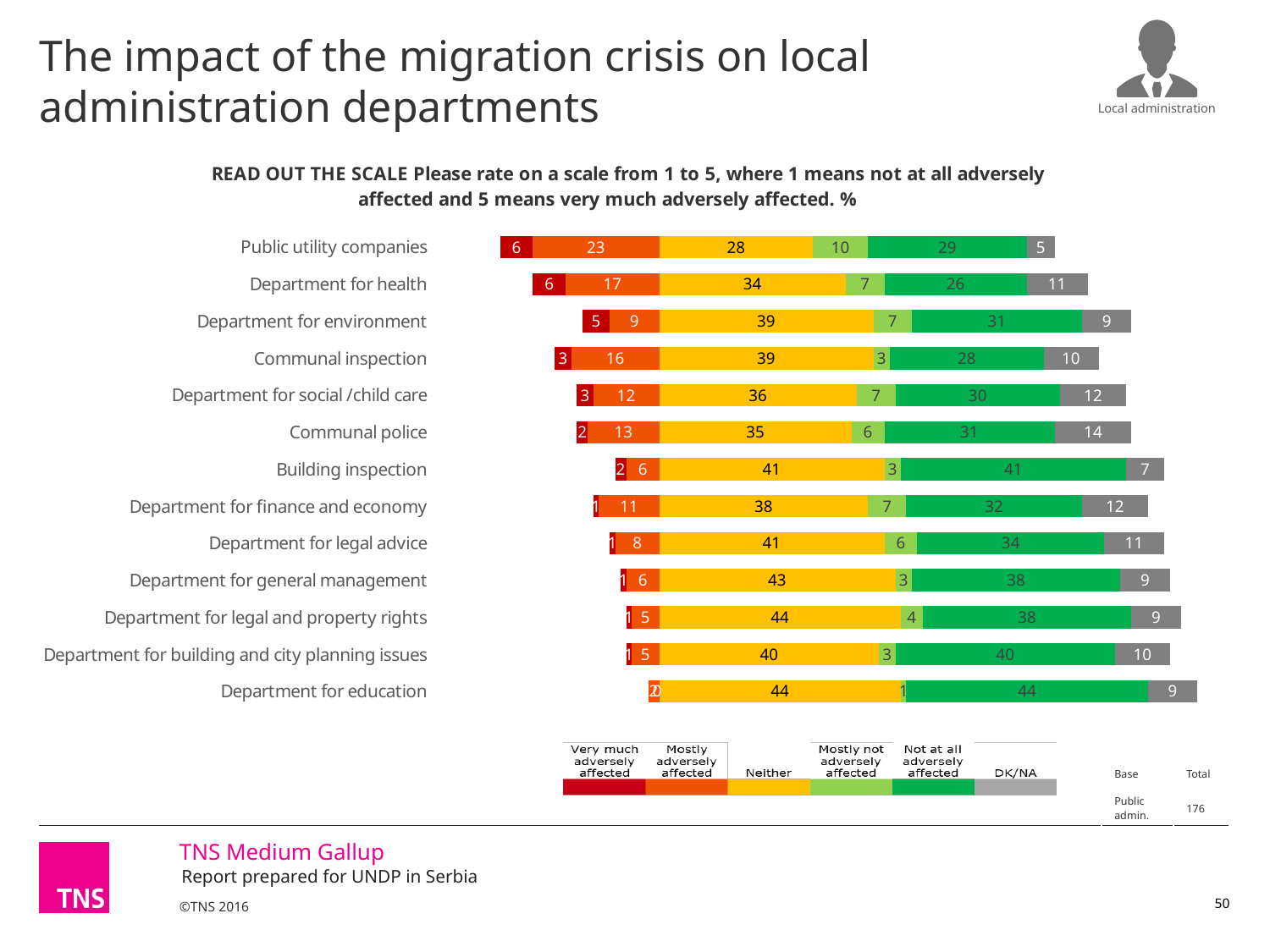
What is the 'Neither' value for the Department for general management? 43 What is the base (number of respondents) shown for Public admin.? 176 Which category has the highest 'Mostly adversely affected' value? Public utility companies What is the difference between the 'Mostly adversely affected' values for Public utility companies and the Department for health? 6 How many series does the legend list? 6 Which has a larger 'Neither' value: the Department for general management or the Department for environment? Department for general management What is the DK/NA value for Communal police? 14 Which category has the highest DK/NA value? Communal police What is the 'Not at all adversely affected' value for the Department for environment? 31 What percentage of respondents said public utility companies were mostly adversely affected? 23 How many categories (departments) are shown in the chart? 13 What kind of chart is shown on the slide? Stacked bar chart